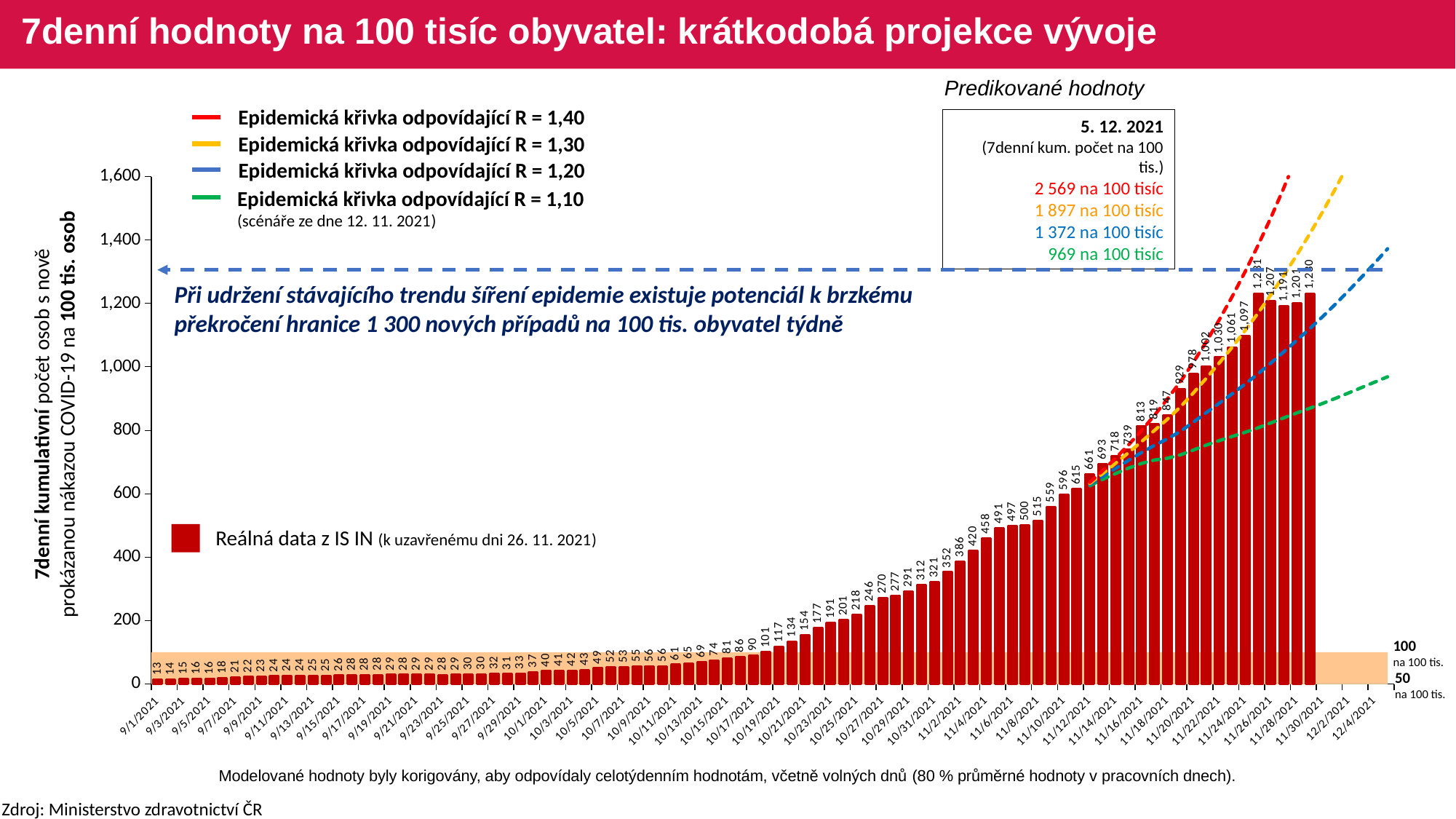
Do the bar values rise or fall from 9/1/2021 to 11/30/2021? rise What is the value of the first bar, for 9/1/2021? 13 What colour is the line for the epidemic curve with R = 1,40? red What kind of chart shows the real data (Reálná data z IS IN) on this slide? bar chart Which predicted value for 5. 12. 2021 is larger: the one for R = 1,30 or the one for R = 1,20? R = 1,30 What is the predicted value for 5. 12. 2021 for the epidemic curve with R = 1,40? 2 569 na 100 tisíc What is the difference between the predicted values for R = 1,40 and R = 1,10 on 5. 12. 2021? 1 600 What is the predicted value for 5. 12. 2021 for the epidemic curve with R = 1,10? 969 na 100 tisíc How many epidemic curve scenarios (Epidemická křivka) does the legend list? 4 Which date has the lowest bar value? 9/1/2021 Is the value of the last bar (11/30/2021) greater or less than 1,000? greater